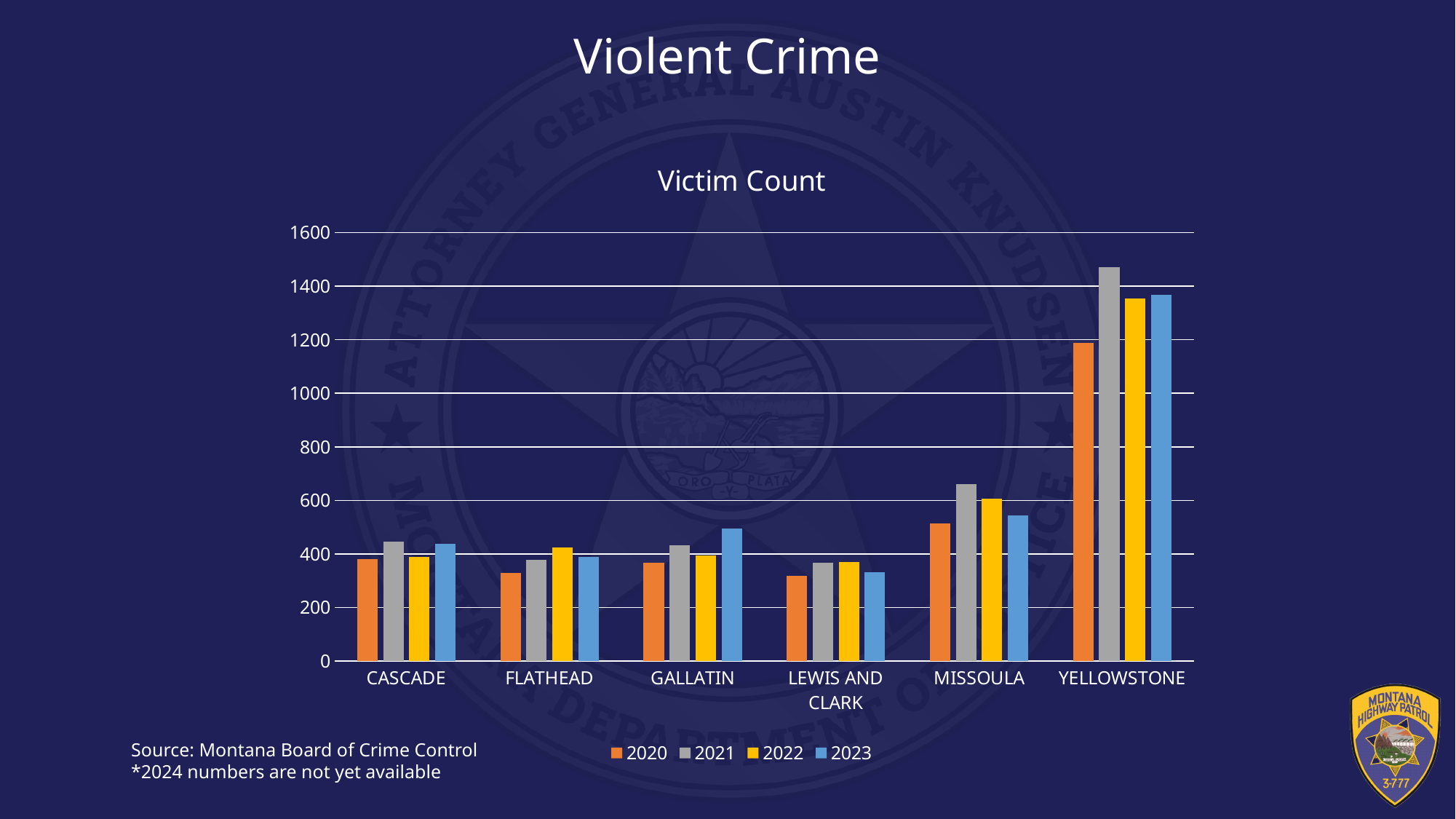
For Yellowstone, which year has the highest victim count? 2021 What kind of chart is shown on the slide? Bar chart For Missoula, which year has the larger victim count, 2021 or 2023? 2021 Which county has the highest victim count for 2021? Yellowstone Is the 2021 value for Yellowstone greater or less than 1400? greater What is the title of the chart? Victim Count How many series does the legend list? 4 How many counties are shown on the x axis? 6 Is the 2021 value for Missoula greater or less than 600? greater Which county has the lowest victim count for 2020? Lewis and Clark For Gallatin, which year has the larger victim count, 2020 or 2023? 2023 Is the 2020 value for Flathead greater or less than 400? less